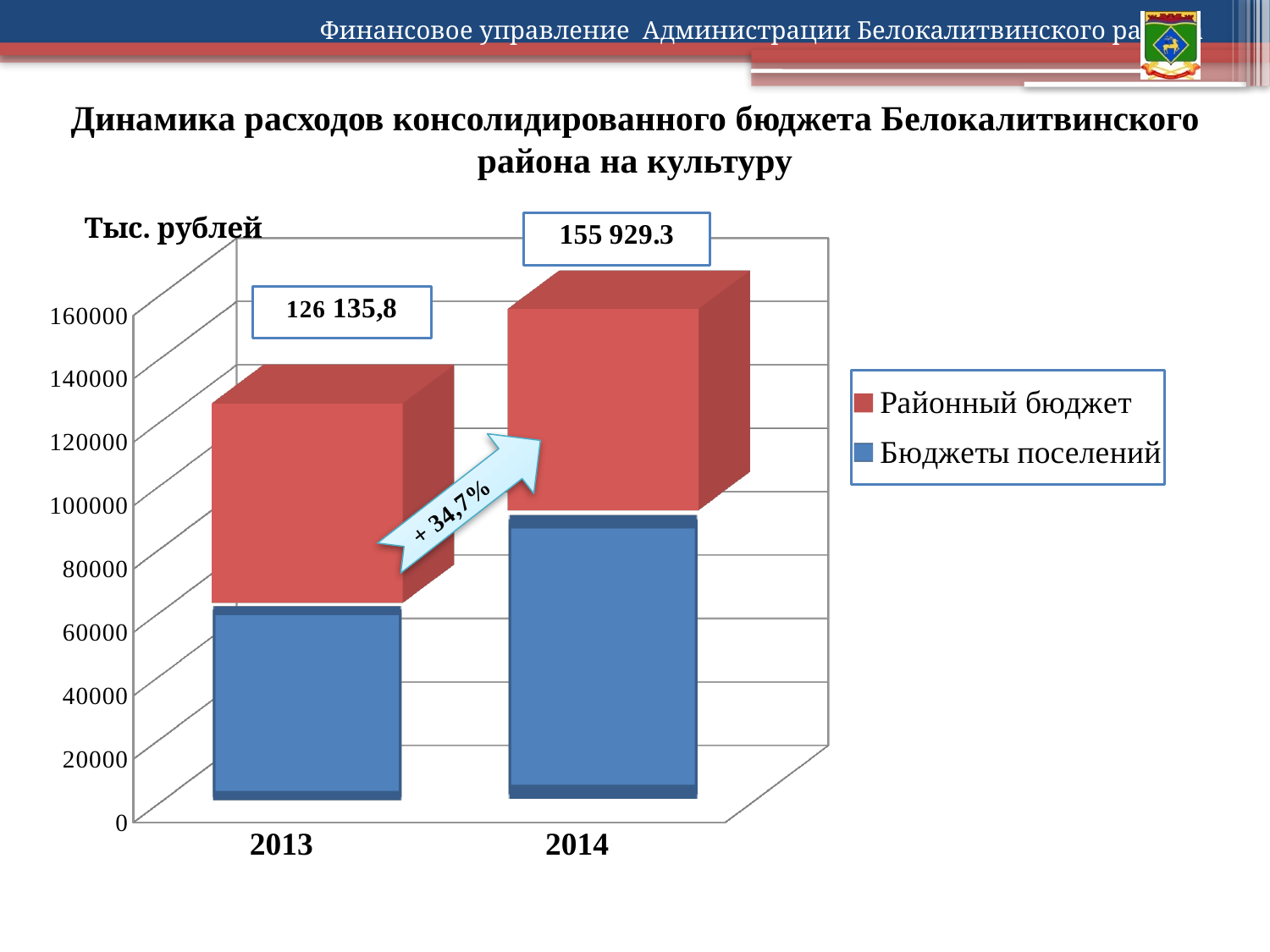
What is the total consolidated budget expenditure on culture shown for 2014? 155 929.3 By how much does the 2014 total exceed the 2013 total? 29 793.5 Is the value for Бюджеты поселений in 2014 greater or less than 80000? greater Which year has the higher total expenditure on culture, 2013 or 2014? 2014 How many years (categories) are shown on the x axis? 2 How many series does the legend list? 2 What kind of chart is shown on the slide? Stacked bar chart What percentage change is shown on the arrow between 2013 and 2014? + 34,7% Do the total expenditures rise or fall from 2013 to 2014? Rise Is the value for Бюджеты поселений in 2013 greater or less than 40000? greater What is the total consolidated budget expenditure on culture shown for 2013? 126 135,8 Is the value for Бюджеты поселений in 2013 greater or less than 80000? less